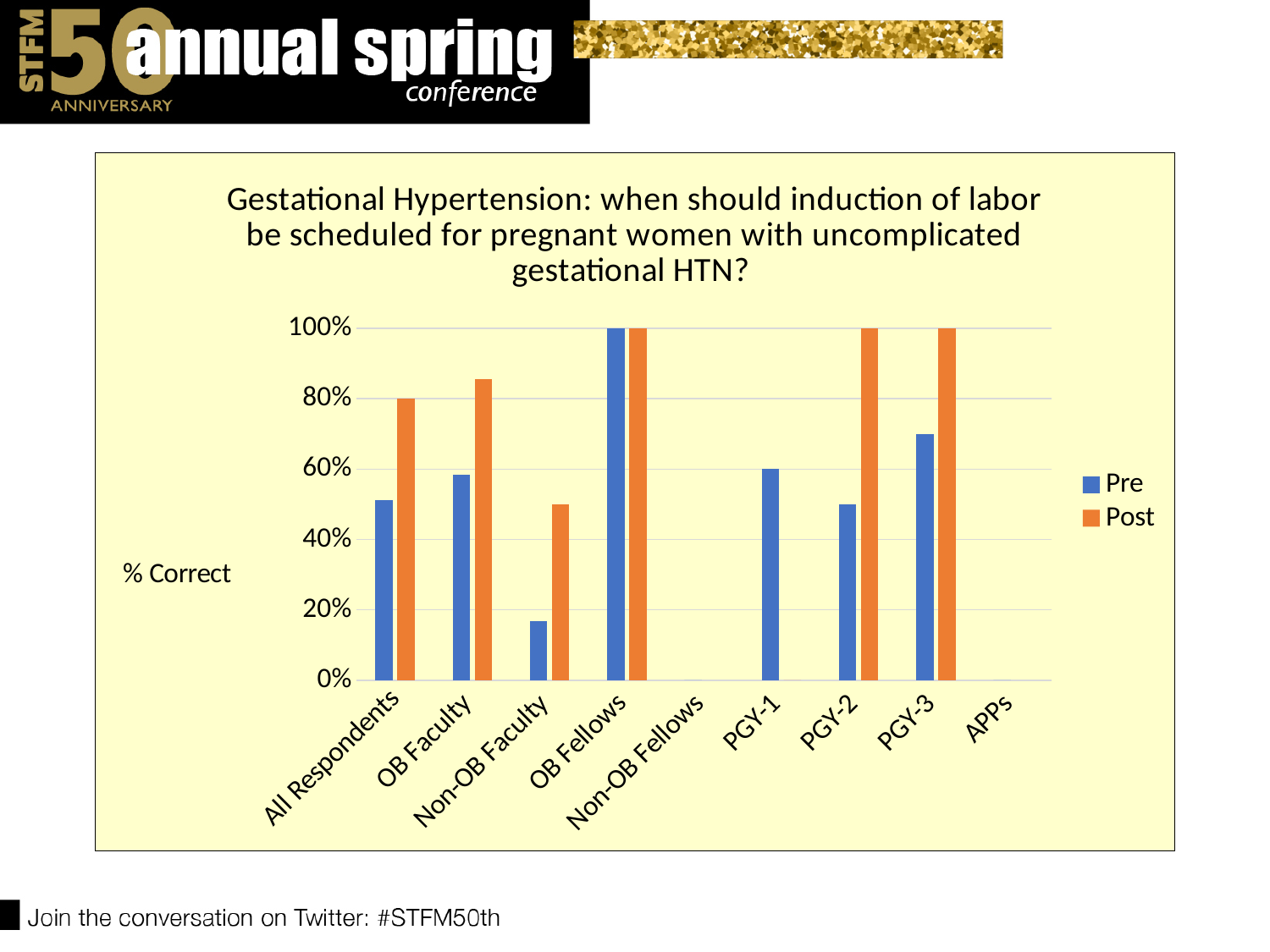
What is the Pre value for PGY-1? 60% Is the Pre value for Non-OB Faculty greater or less than 20%? less What is the Post value for All Respondents? 80% What is the difference between the Post value for OB Fellows and the Post value for All Respondents? 20% How many categories are shown on the x axis? 9 What type of chart is shown on the slide? bar chart How many series does the legend list? 2 What is the Post value for PGY-3? 100% Is the Post value for OB Faculty greater or less than 80%? greater What is the Post value for OB Fellows? 100% What is the Pre value for OB Fellows? 100%